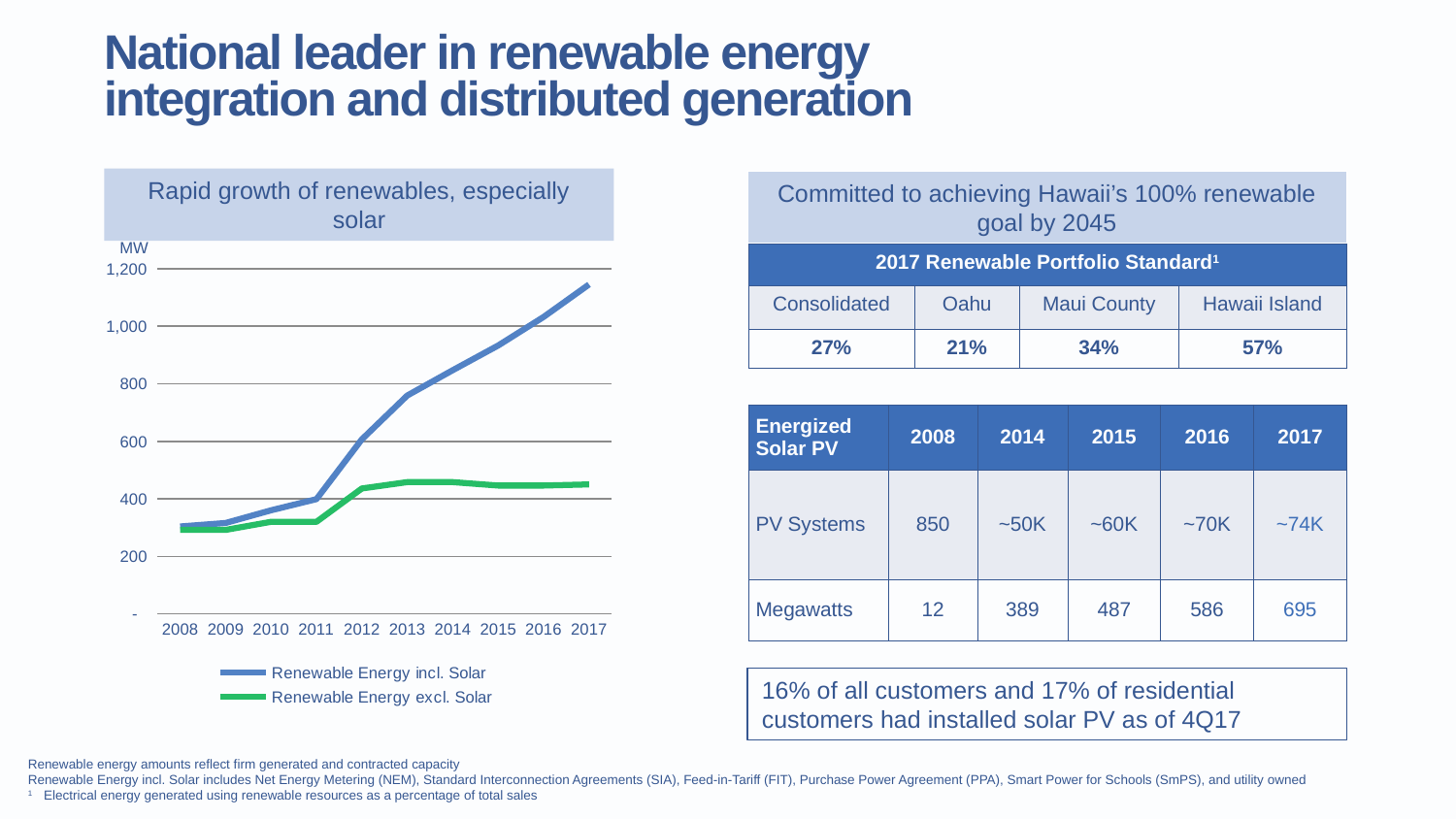
Is the value for Renewable Energy incl. Solar in 2008 greater or less than 400? less How many series does the chart's legend list? 2 In 2017, which is larger: Renewable Energy incl. Solar or Renewable Energy excl. Solar? Renewable Energy incl. Solar Is the value for Renewable Energy incl. Solar in 2017 greater or less than 1,000? greater Does the Renewable Energy incl. Solar line rise or fall from 2008 to 2017? Rise How many years are shown on the x axis of the chart? 10 Is the value for Renewable Energy excl. Solar in 2017 greater or less than 600? less What is the title of the chart? Rapid growth of renewables, especially solar What kind of chart is shown on the slide? Line chart In which year is Renewable Energy incl. Solar highest? 2017 What unit is shown on the chart's vertical axis? MW